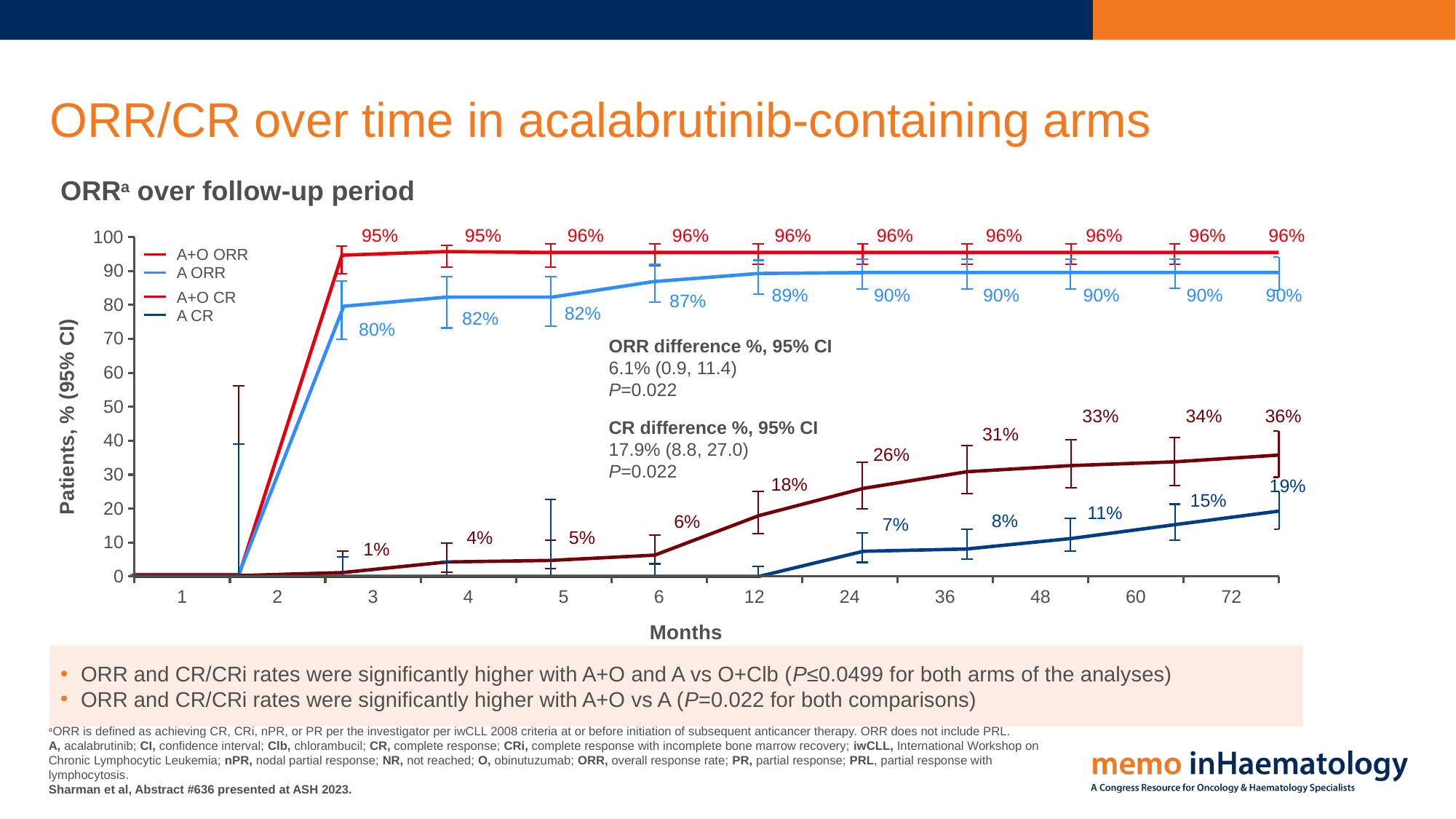
What ORR difference % (95% CI) is stated in the chart annotation? 6.1% (0.9, 11.4) At the last time point, what is the difference between the A+O CR value and the A CR value? 17 percentage points At the last time point, which is higher: A+O ORR or A ORR? A+O ORR What is the A+O ORR value at the last time point on the chart? 96% What is the first labeled A ORR value on the chart? 80% What type of chart is shown on the slide? Line chart What is the A+O CR value at the last time point on the chart? 36% What is the A CR value at the last time point on the chart? 19% What is the highest labeled A+O CR value on the chart? 36% How many series does the chart legend list? 4 What is the first labeled A CR value on the chart? 7% Does the A+O CR line rise or fall over the follow-up period? Rises